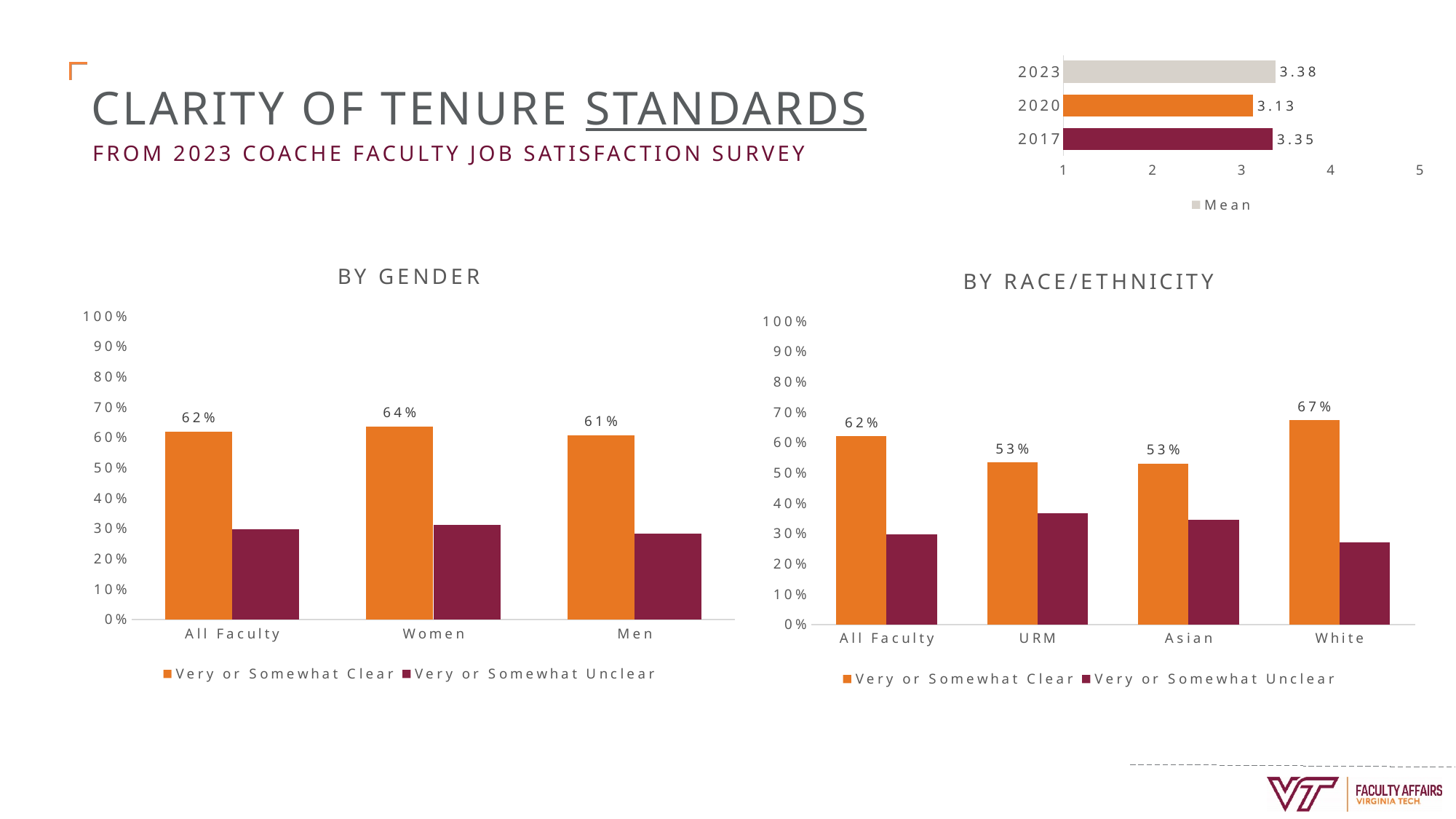
In the By Gender chart, which category has the lowest Very or Somewhat Clear value? Men What kind of chart is the By Gender chart? Bar chart In the By Race/Ethnicity chart, what is the Very or Somewhat Clear value for White faculty? 67% In the top-right Mean chart, what is the mean value for 2023? 3.38 In the top-right Mean chart, which year has the lowest mean? 2020 In the By Race/Ethnicity chart, what is the difference between the Very or Somewhat Clear values for White and URM faculty? 14% In the By Gender chart, how many series does the legend list? 2 In the By Gender chart, is the Very or Somewhat Unclear value for Women greater or less than 40%? less In the By Gender chart, what percentage of Women report tenure standards are Very or Somewhat Clear? 64% In the top-right Mean chart, what is the difference between the 2023 mean and the 2020 mean? 0.25 In the By Race/Ethnicity chart, how many categories are shown on the x axis? 4 In the By Race/Ethnicity chart, is the Very or Somewhat Unclear value for URM greater or less than 30%? greater